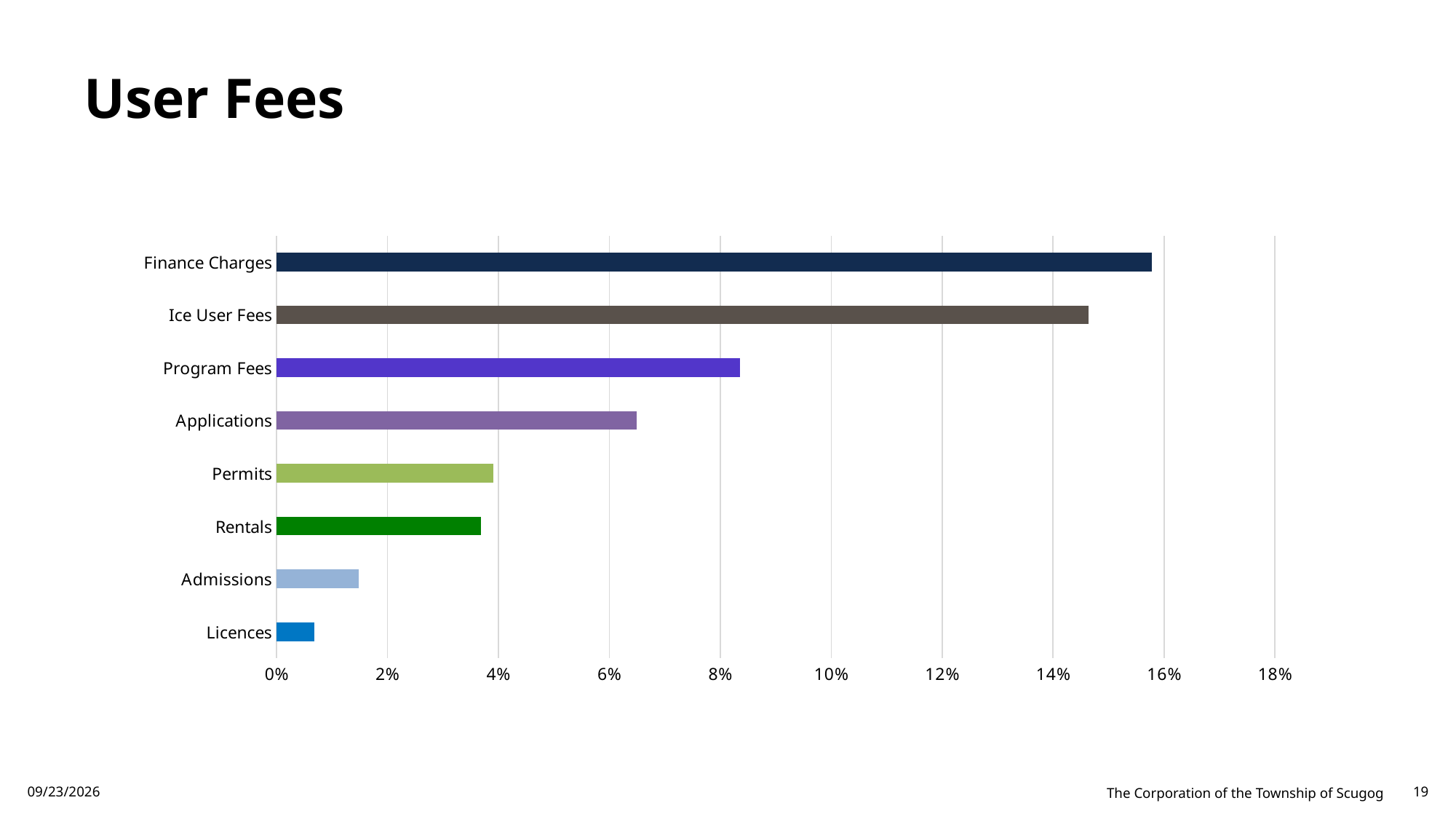
What kind of chart is shown on the slide? bar chart Is the value for Program Fees greater or less than 8%? greater Is the value for Finance Charges greater or less than 14%? greater Which category has the lowest value? Licences Is the value for Admissions greater or less than 2%? less How many categories are plotted in the chart? 8 Which is larger, the value for Finance Charges or the value for Ice User Fees? Finance Charges What is the title of the slide containing the chart? User Fees Which is larger, the value for Program Fees or the value for Applications? Program Fees Which category has the highest value? Finance Charges